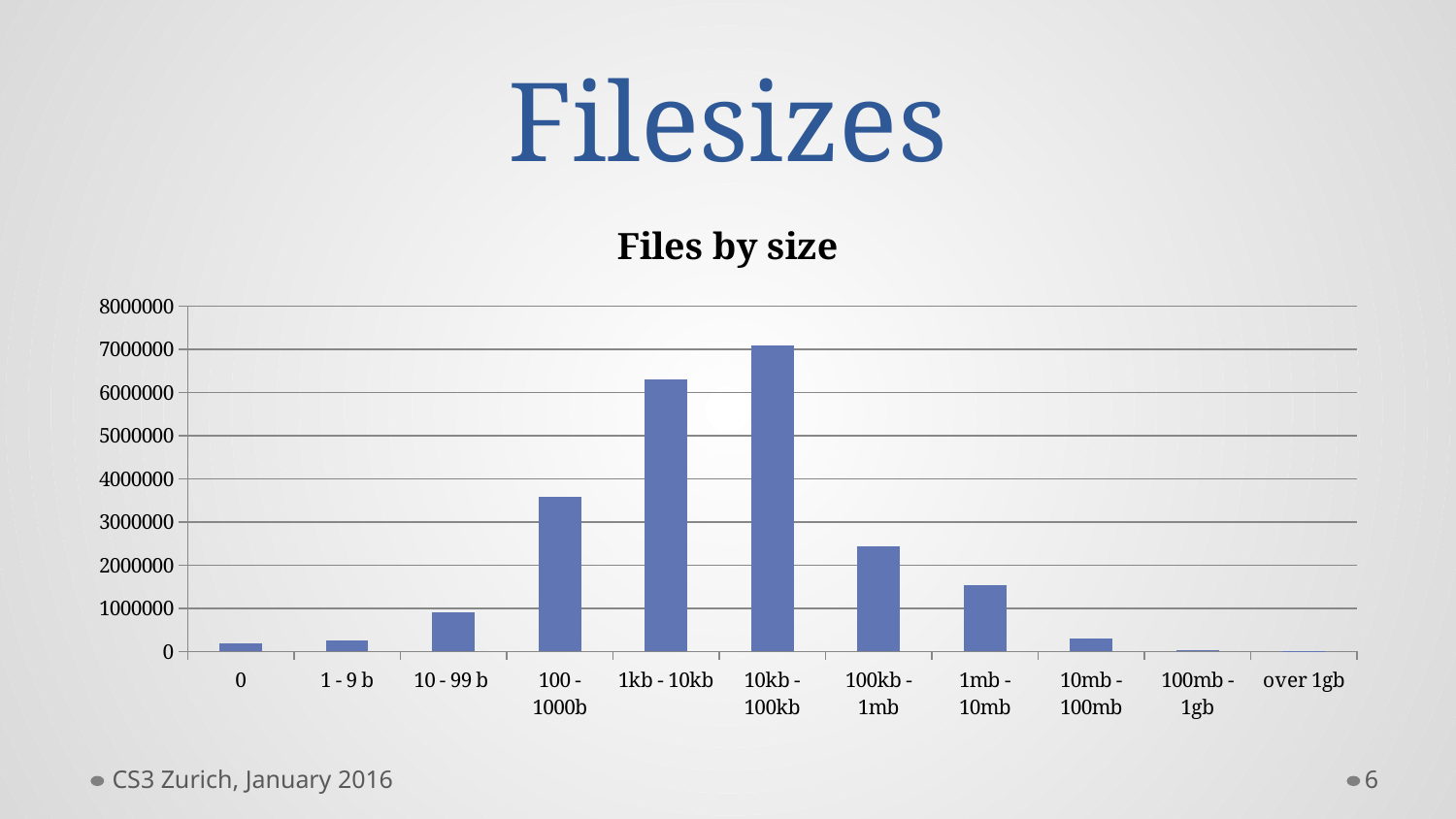
Is the value for 100 - 1000b greater or less than 4000000? less Which has more files, 100 - 1000b or 10mb - 100mb? 100 - 1000b Is the value for 10 - 99 b greater or less than 1000000? less Which size category has the highest number of files? 10kb - 100kb Do the values rise or fall along the x axis from 10kb - 100kb to over 1gb? fall Is the value for 1kb - 10kb greater or less than 6000000? greater What kind of chart is shown on the slide? bar chart How many size categories are shown on the x axis? 11 Which size category has the lowest number of files? over 1gb What is the title of the chart? Files by size Which has more files, 100kb - 1mb or 1mb - 10mb? 100kb - 1mb